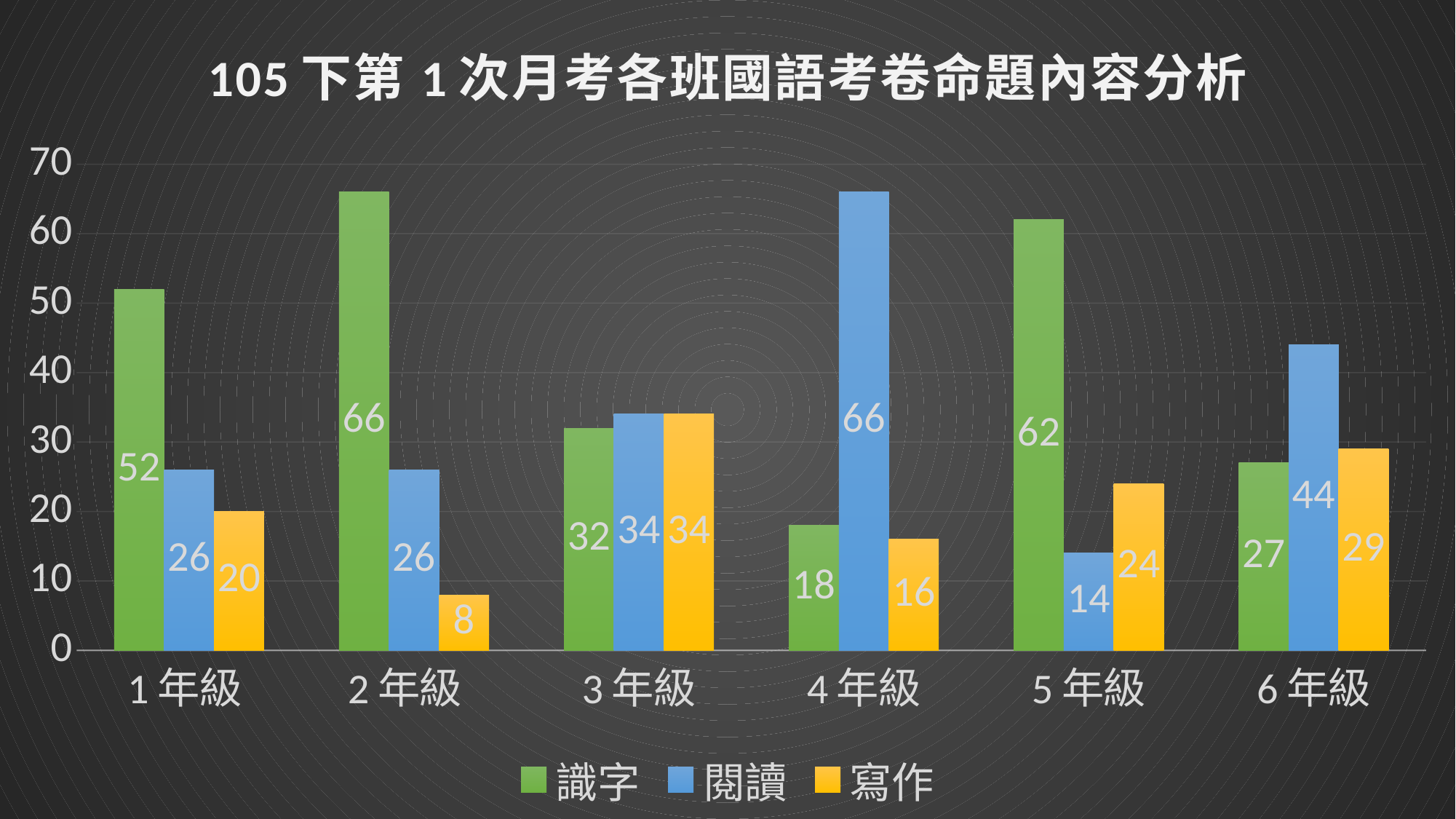
What is the value of 閱讀 for 6 年級? 44 How many series does the legend list? 3 What kind of chart is shown on the slide? Bar chart What is the value of 寫作 for 2 年級? 8 Which grade has the highest 閱讀 value? 4 年級 How many grade categories are shown on the x axis? 6 What is the value of 識字 for 2 年級? 66 What is the difference between the 識字 and 閱讀 values for 5 年級? 48 What is the title of the chart? 105 下第 1 次月考各班國語考卷命題內容分析 Which grade has the lowest 寫作 value? 2 年級 For 4 年級, which is larger: 識字 or 寫作? 識字 What is the total of the three values for 1 年級? 98